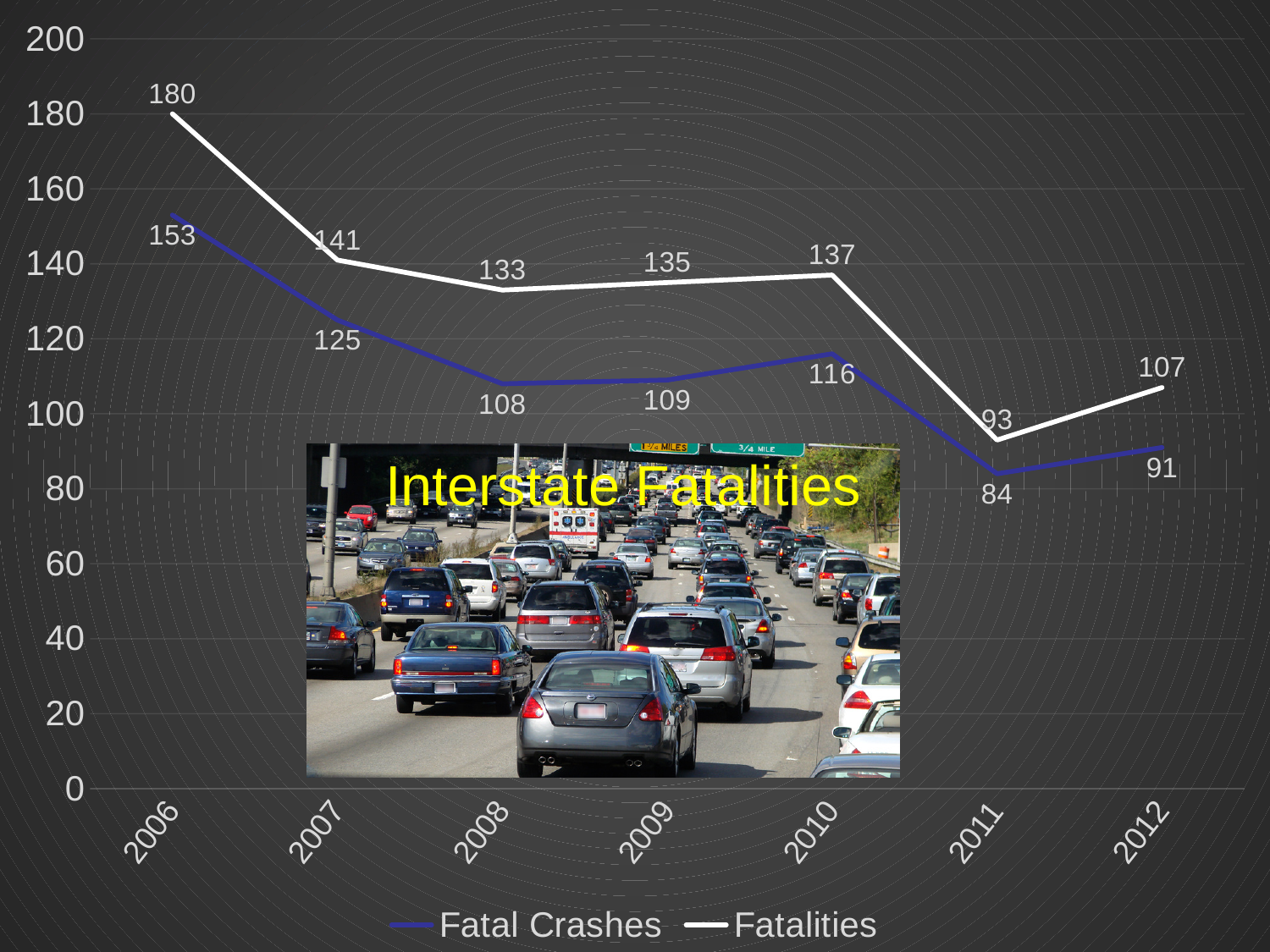
In which year were Fatal Crashes lowest? 2011 What kind of chart is this? Line chart Which is larger: Fatal Crashes in 2009 or Fatal Crashes in 2010? Fatal Crashes in 2010 What was the number of Fatalities in 2006? 180 What was the number of Fatalities in 2012? 107 What is the title shown on the chart? Interstate Fatalities In which year were Fatalities highest? 2006 How many years are shown on the x axis? 7 What is the difference between Fatalities and Fatal Crashes in 2011? 9 How much did Fatalities decrease from 2006 to 2007? 39 What was the number of Fatal Crashes in 2010? 116 How many series does the legend list? 2